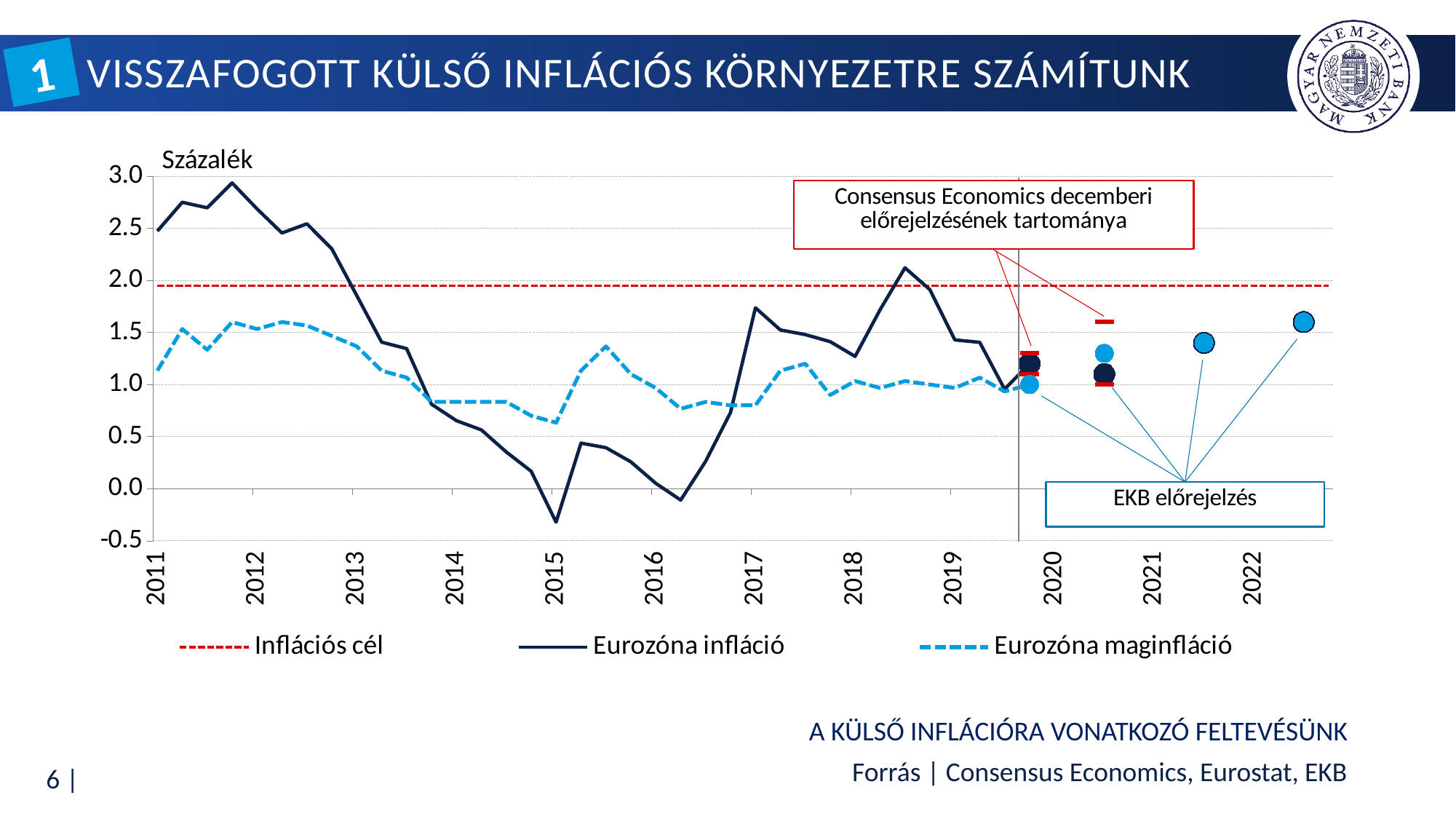
Is the peak of Eurozóna infláció in 2018 greater or less than 2.0? greater Does Eurozóna infláció rise or fall between 2012 and 2015? fall Which legend entry is drawn as a red dashed line? Inflációs cél How many year labels are shown on the x axis? 12 What unit label is shown at the top of the y axis? Százalék At the start of 2011, which is higher: Eurozóna infláció or Eurozóna maginfláció? Eurozóna infláció What kind of chart is shown on the slide? line chart Is the value of Eurozóna infláció at the start of 2011 greater or less than 2.0? greater Is the value of Eurozóna maginfláció at the start of 2014 greater or less than 1.0? less How many series does the legend list? 3